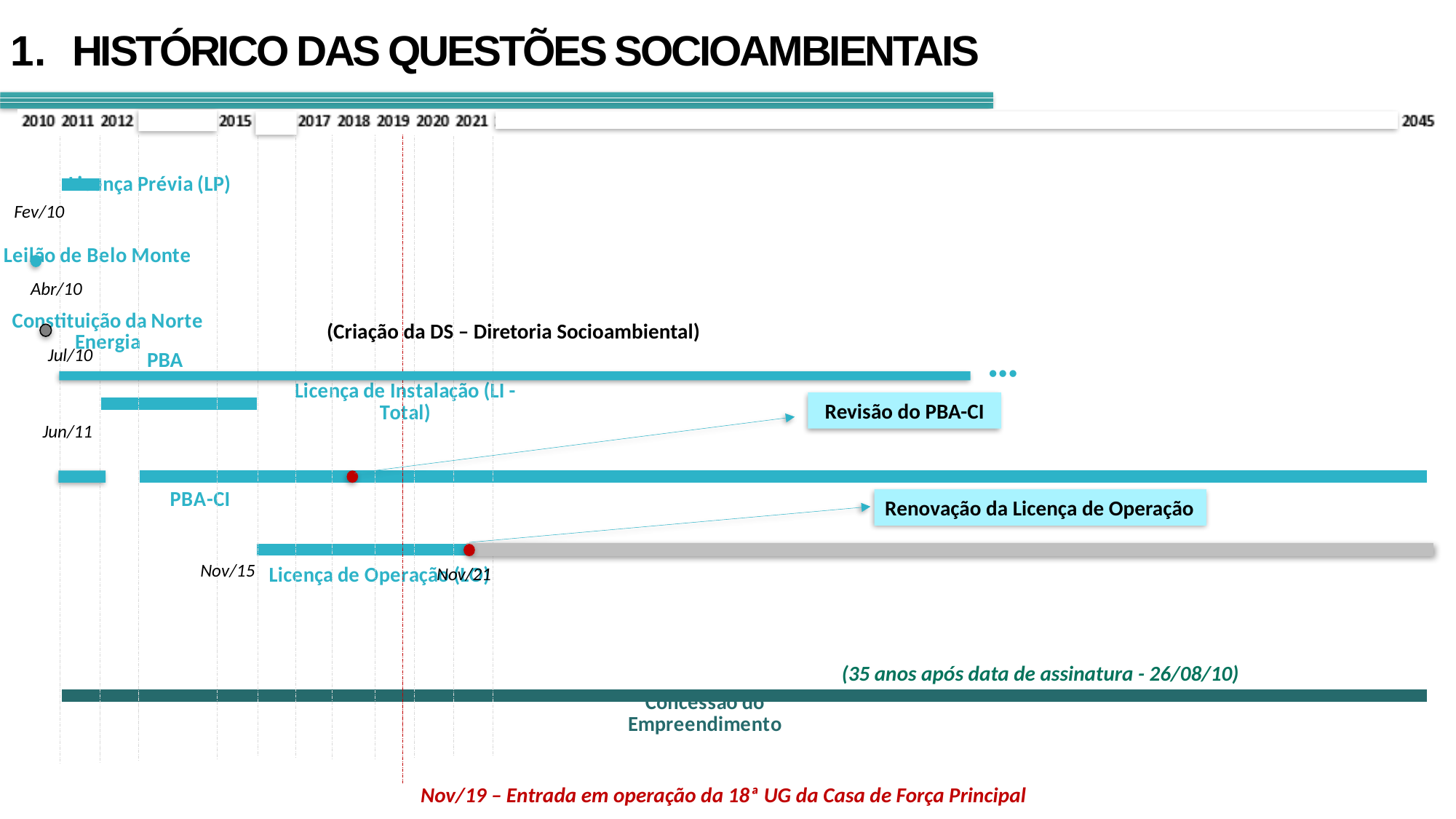
What kind of chart is shown on the slide? Gantt chart (horizontal bar timeline) In which month and year was the Licença Prévia (LP) issued, according to the timeline? Fev/10 What signing date is given for the Concessão do Empreendimento (35 years after signature)? 26/08/10 When does the Licença de Operação (LO) bar begin? Nov/15 When did the Leilão de Belo Monte take place, according to the timeline? Abr/10 Which callout box is linked to the red marker on the PBA-CI bar? Revisão do PBA-CI What date is marked for the Renovação da Licença de Operação? Nov/21 What date is shown for the start of the Licença de Instalação (LI - Total)? Jun/11 What date is shown for the Constituição da Norte Energia? Jul/10 What is the first year shown on the timeline axis? 2010 What event is noted in red at the bottom of the timeline for Nov/19? Entrada em operação da 18ª UG da Casa de Força Principal What is the last year shown on the timeline axis? 2045